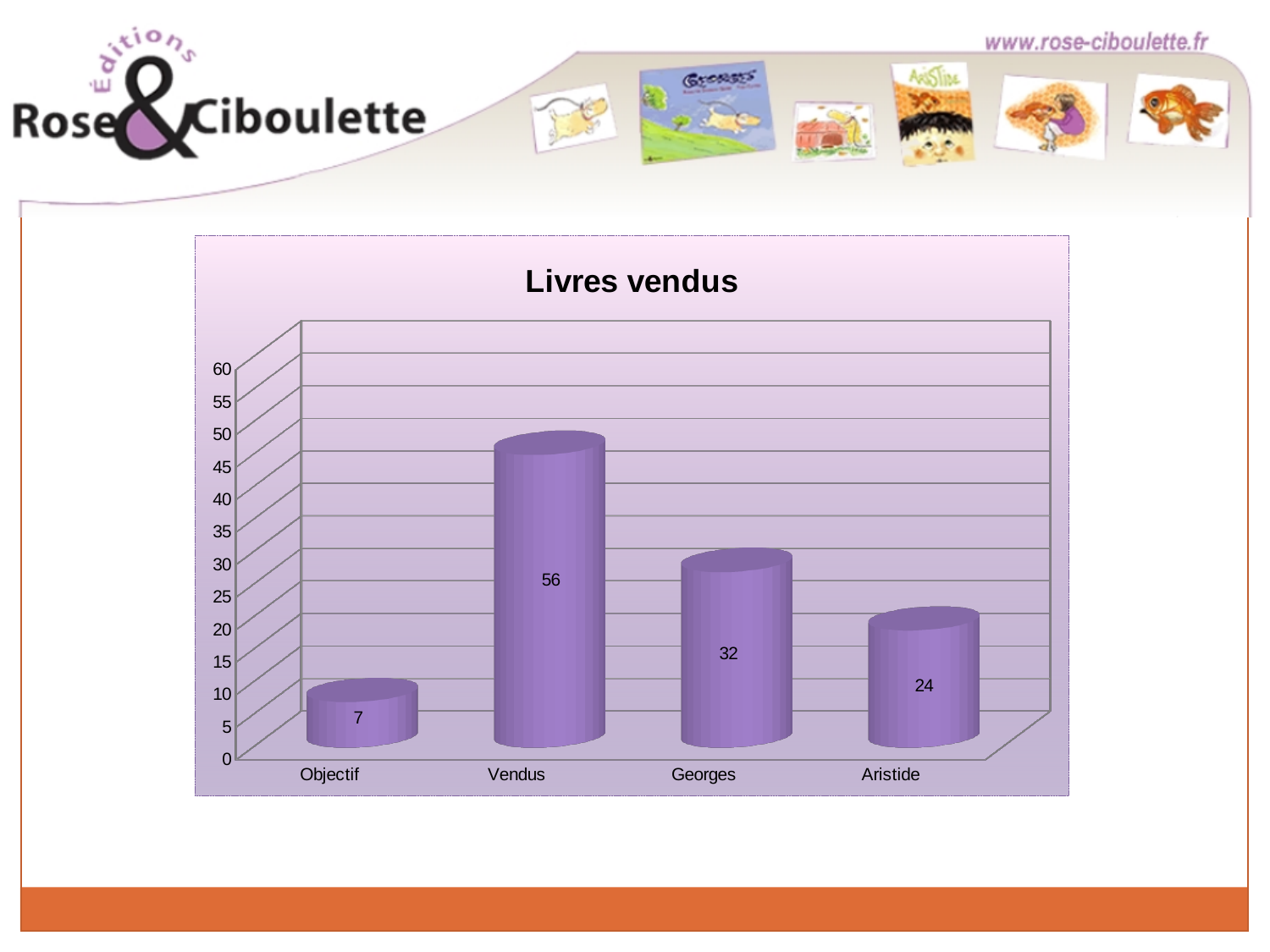
What is the value for Objectif in the Livres vendus chart? 7 What is the difference between the values for Georges and Aristide? 8 What is the value for Aristide in the Livres vendus chart? 24 How many categories are shown on the x axis of the Livres vendus chart? 4 What is the value for Georges in the Livres vendus chart? 32 Which is larger, the value for Georges or the value for Aristide? Georges What is the title of the chart on the slide? Livres vendus Which category has the lowest value in the Livres vendus chart? Objectif What kind of chart is shown on the slide? Bar chart Which category has the highest value in the Livres vendus chart? Vendus What is the difference between the values for Vendus and Georges? 24 What is the value for Vendus in the Livres vendus chart? 56